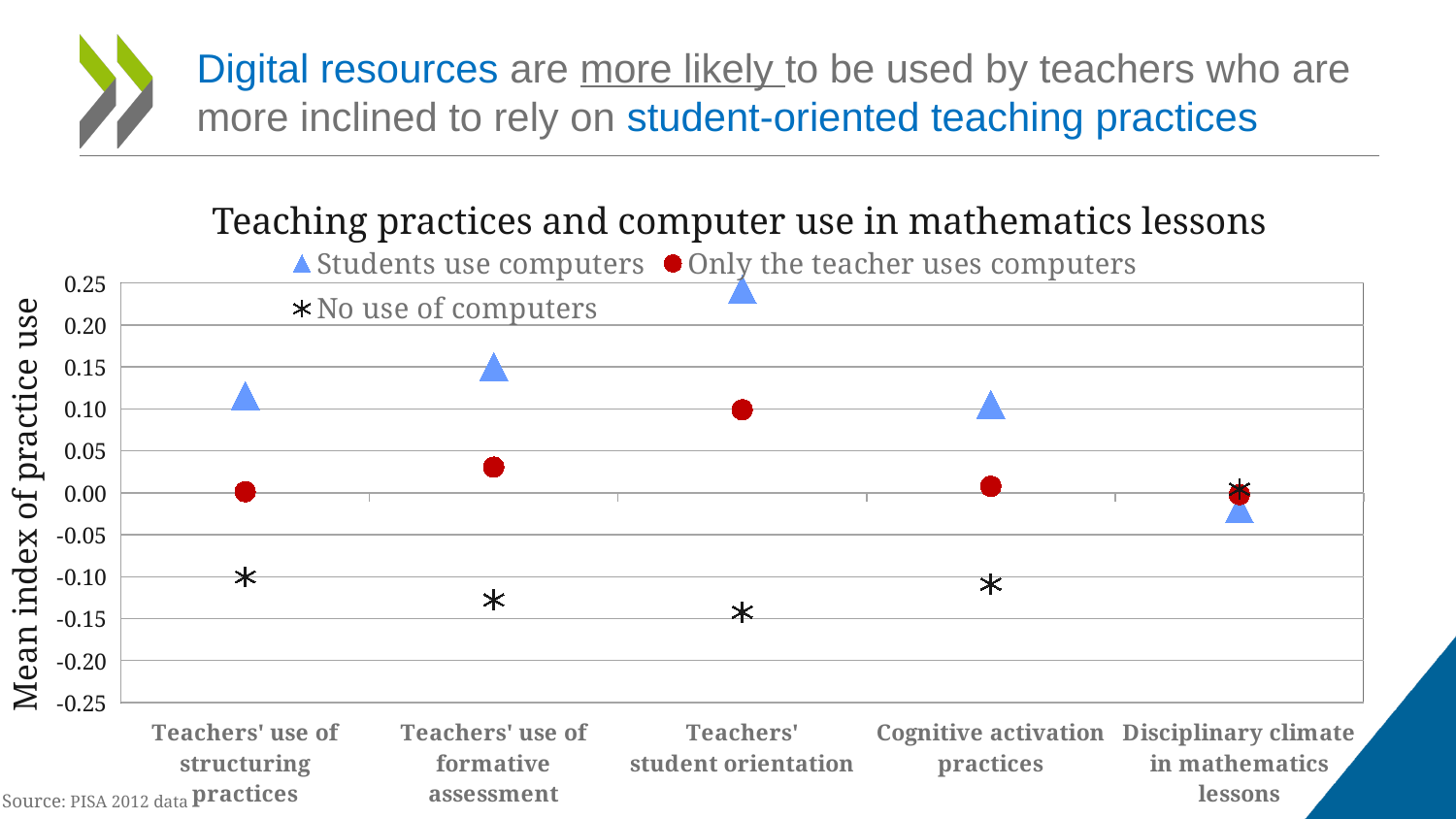
Is the value for 'No use of computers' at Teachers' use of structuring practices greater or less than -0.05? less For which category is the value for 'Only the teacher uses computers' highest? Teachers' student orientation For which category is the value for 'Students use computers' lowest? Disciplinary climate in mathematics lessons What is the title of the chart? Teaching practices and computer use in mathematics lessons At Teachers' use of formative assessment, which is larger: 'Students use computers' or 'Only the teacher uses computers'? Students use computers How many series does the legend list? 3 For which category is the value for 'Students use computers' highest? Teachers' student orientation What is the label on the vertical axis of the chart? Mean index of practice use How many teaching practice categories are shown on the x axis? 5 Is the value for 'Only the teacher uses computers' at Teachers' student orientation greater or less than 0.05? greater Is the value for 'Students use computers' at Teachers' student orientation greater or less than 0.20? greater At Cognitive activation practices, which is larger: 'Only the teacher uses computers' or 'No use of computers'? Only the teacher uses computers